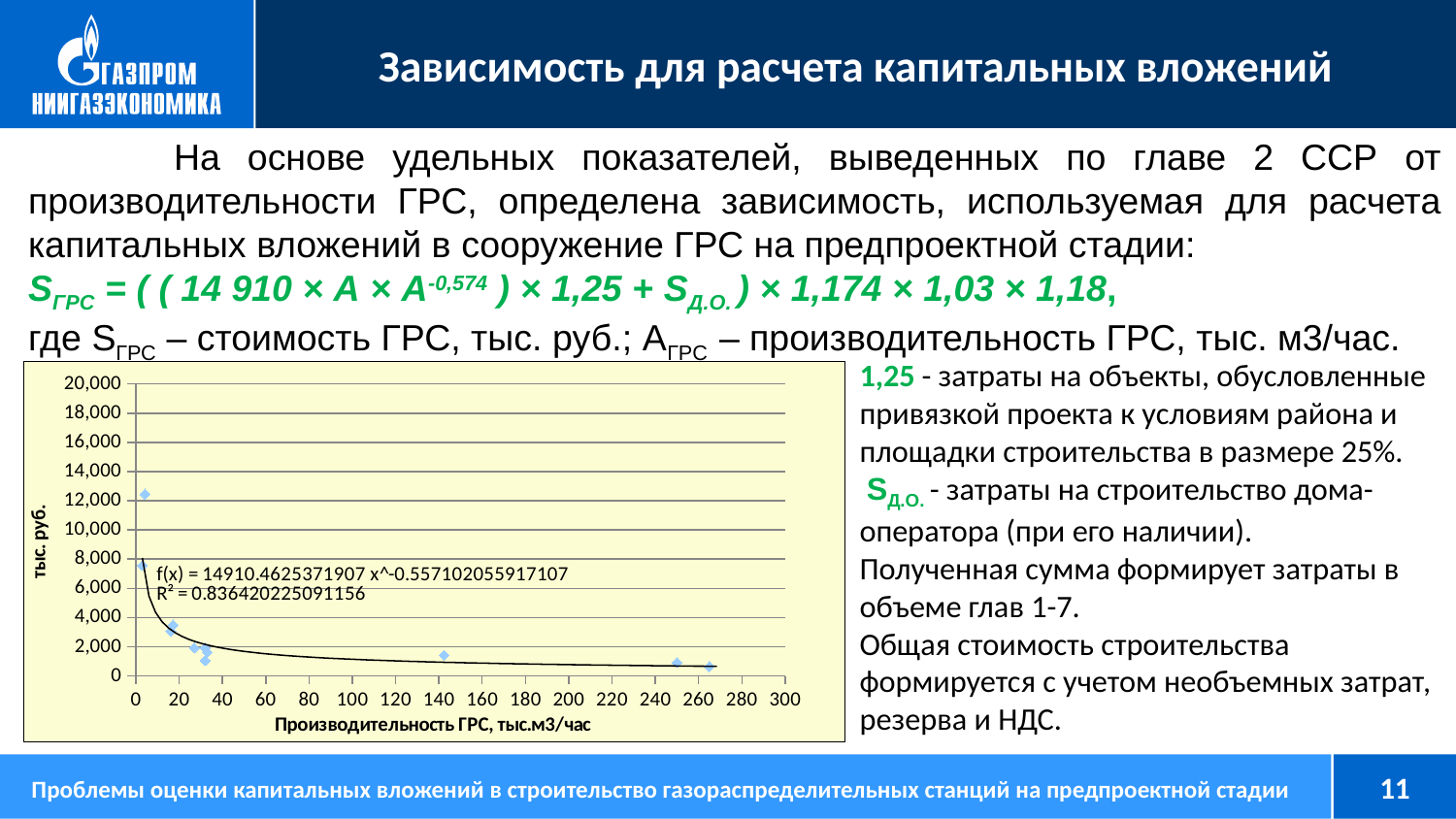
Is the value of the point plotted near 260 on the x axis greater or less than 2,000? less What R² value is printed on the chart for the trendline? R² = 0.836420225091156 Which is larger: the value of the point near 20 on the x axis or the value of the point near 140 on the x axis? the point near 20 Is the value of the point plotted near 140 on the x axis greater or less than 4,000? less What kind of chart is shown on the slide? scatter chart Do the plotted values rise or fall as productivity increases along the x axis? fall What trendline equation is printed on the chart? f(x) = 14910.4625371907 x^-0.557102055917107 Is the value of the highest plotted point greater or less than 10,000? greater What is the title of the y axis of the chart? тыс. руб. What is the maximum value shown on the x axis? 300 What is the title of the x axis of the chart? Производительность ГРС, тыс.м3/час What is the maximum value shown on the y axis? 20,000